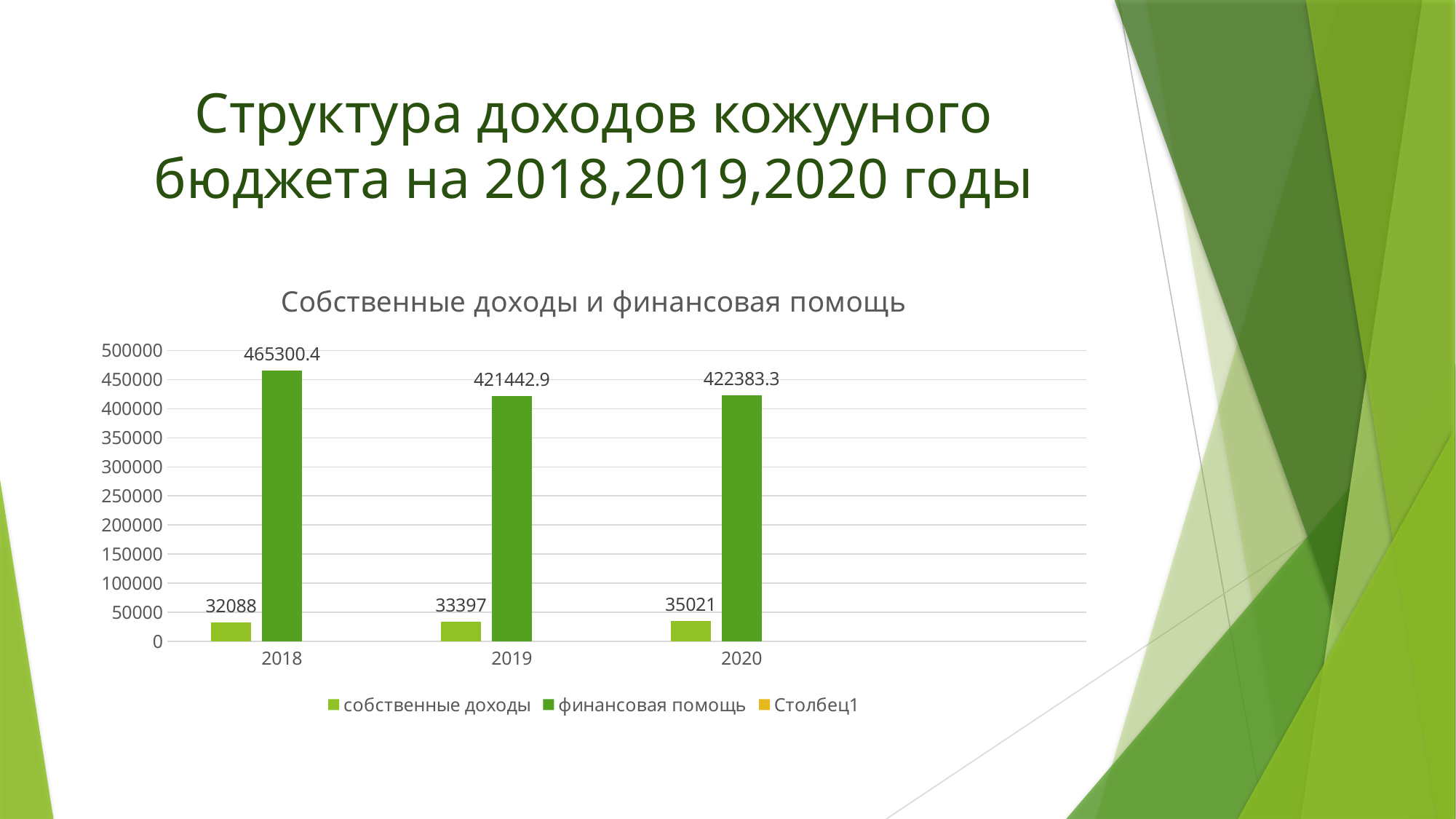
How many series does the legend list? 3 What is the difference between финансовая помощь in 2018 and in 2019? 43857.5 What is the value of собственные доходы for 2018? 32088 What is the value of финансовая помощь for 2020? 422383.3 What is the difference between собственные доходы in 2020 and in 2018? 2933 What type of chart is shown on the slide? bar chart How many years are shown on the x axis? 3 In which year is собственные доходы the lowest? 2018 In which year is финансовая помощь the highest? 2018 Which is larger: финансовая помощь in 2018 or финансовая помощь in 2020? финансовая помощь in 2018 Do the values of собственные доходы rise or fall from 2018 to 2020? rise What is the value of финансовая помощь for 2019? 421442.9